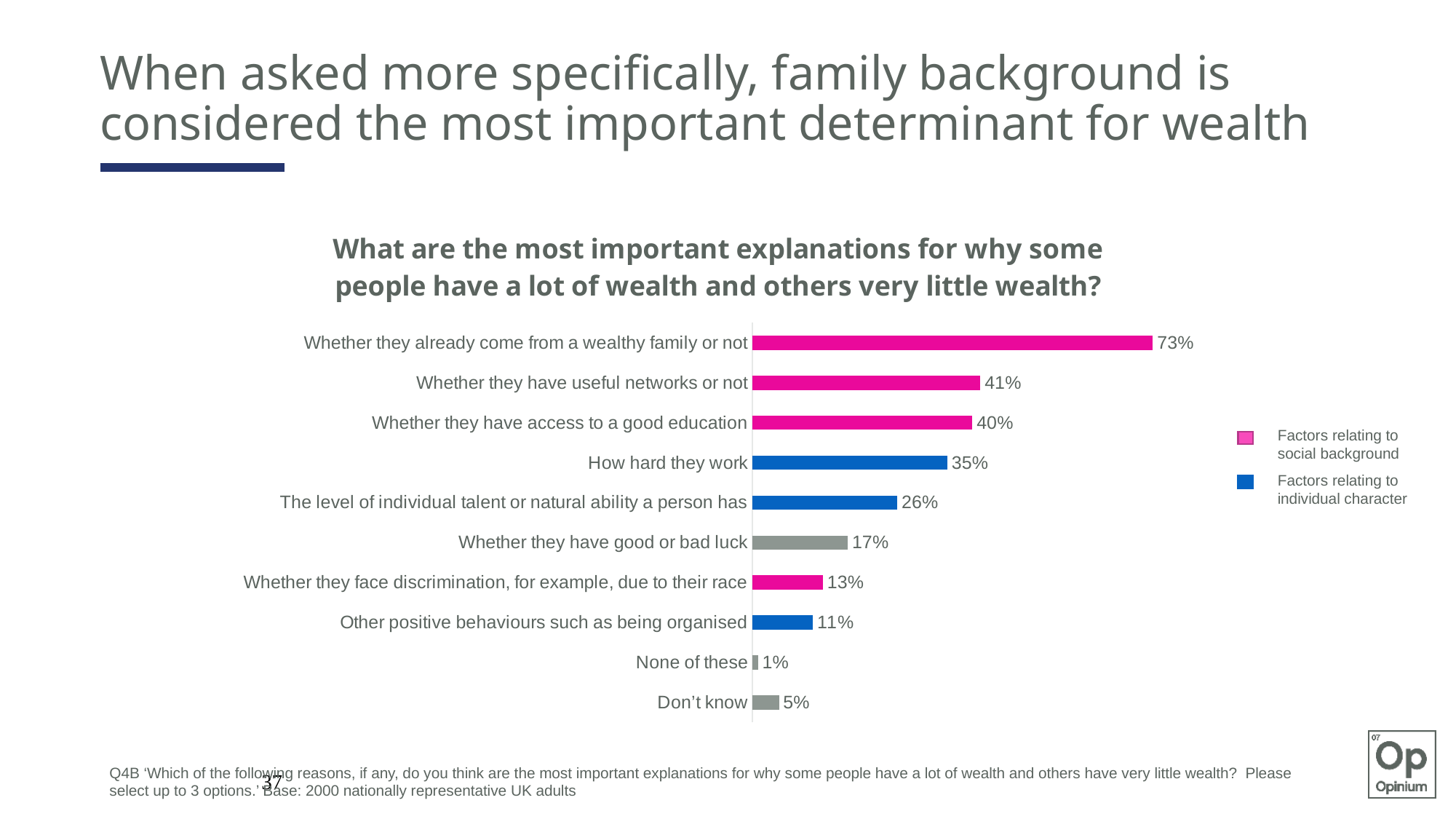
Which category has the lowest value? None of these Which legend entry is shown in pink? Factors relating to social background How many categories are shown in the chart? 10 What percentage of respondents chose 'Whether they already come from a wealthy family or not'? 73% How many series does the legend list? 2 What is the difference between 'Whether they already come from a wealthy family or not' and 'How hard they work'? 38% Which category has the highest value? Whether they already come from a wealthy family or not What is the value for 'How hard they work'? 35% Which is larger: 'The level of individual talent or natural ability a person has' or 'Whether they have good or bad luck'? The level of individual talent or natural ability a person has What is the difference between 'Whether they have useful networks or not' and 'Whether they have access to a good education'? 1% What kind of chart is shown on the slide? Bar chart What percentage selected 'Whether they have good or bad luck'? 17%